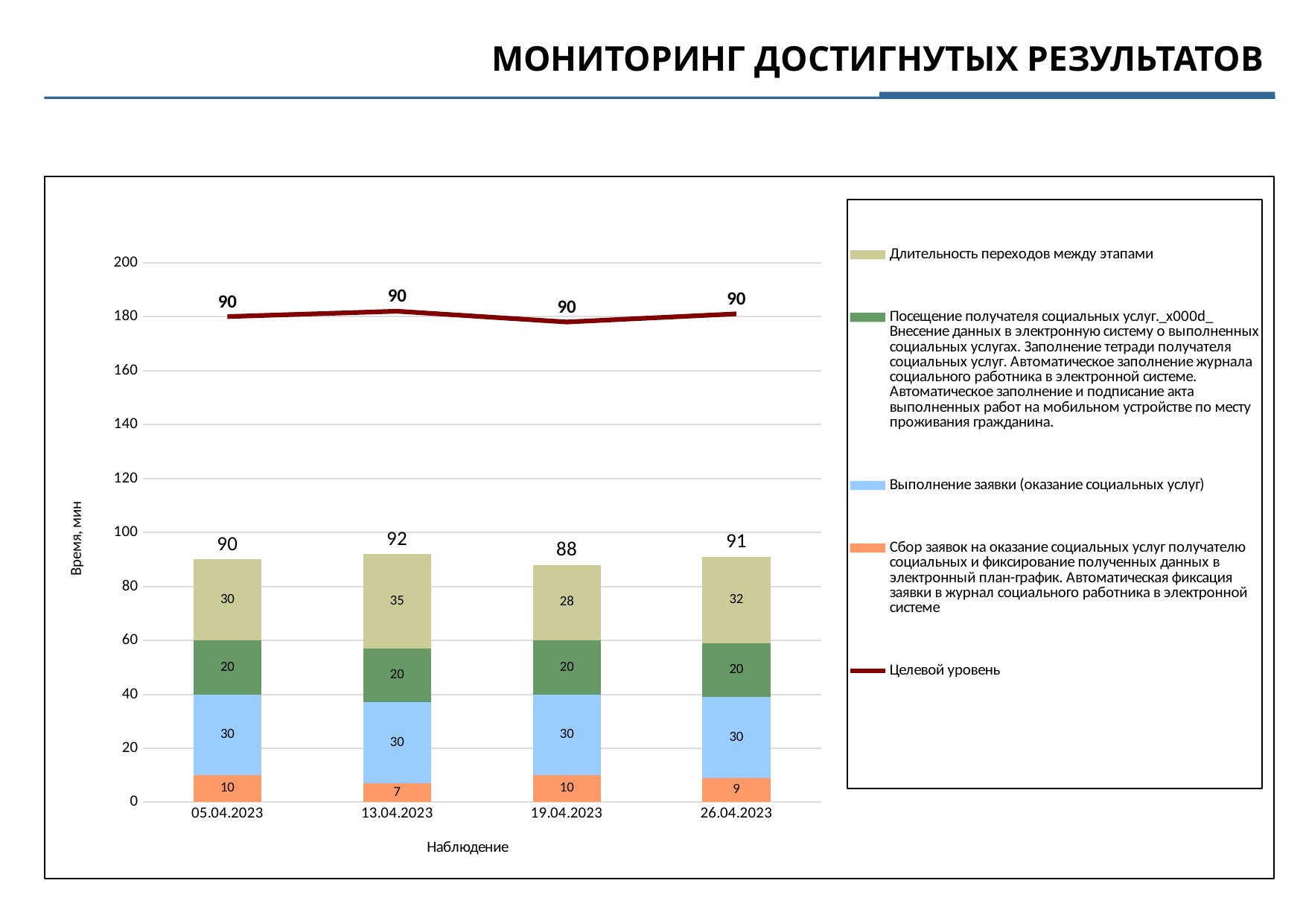
Which observation date has the lowest stacked bar total? 19.04.2023 Which date has the larger 'Длительность переходов между этапами' value, 13.04.2023 or 26.04.2023? 13.04.2023 How many entries does the legend list? 5 What is the title of the vertical axis? Время, мин What is the difference between the stacked bar totals for 13.04.2023 and 19.04.2023? 4 What kind of chart is used to show the observation data? Stacked bar chart with a line Which observation date has the highest stacked bar total? 13.04.2023 How many observation dates are shown on the x axis? 4 What is the total value shown above the stacked bar for 13.04.2023? 92 What is the value of the 'Длительность переходов между этапами' segment for 19.04.2023? 28 What value is labelled on the 'Целевой уровень' line for 26.04.2023? 90 What is the value of the 'Сбор заявок на оказание социальных услуг получателю...' (orange) segment for 13.04.2023? 7